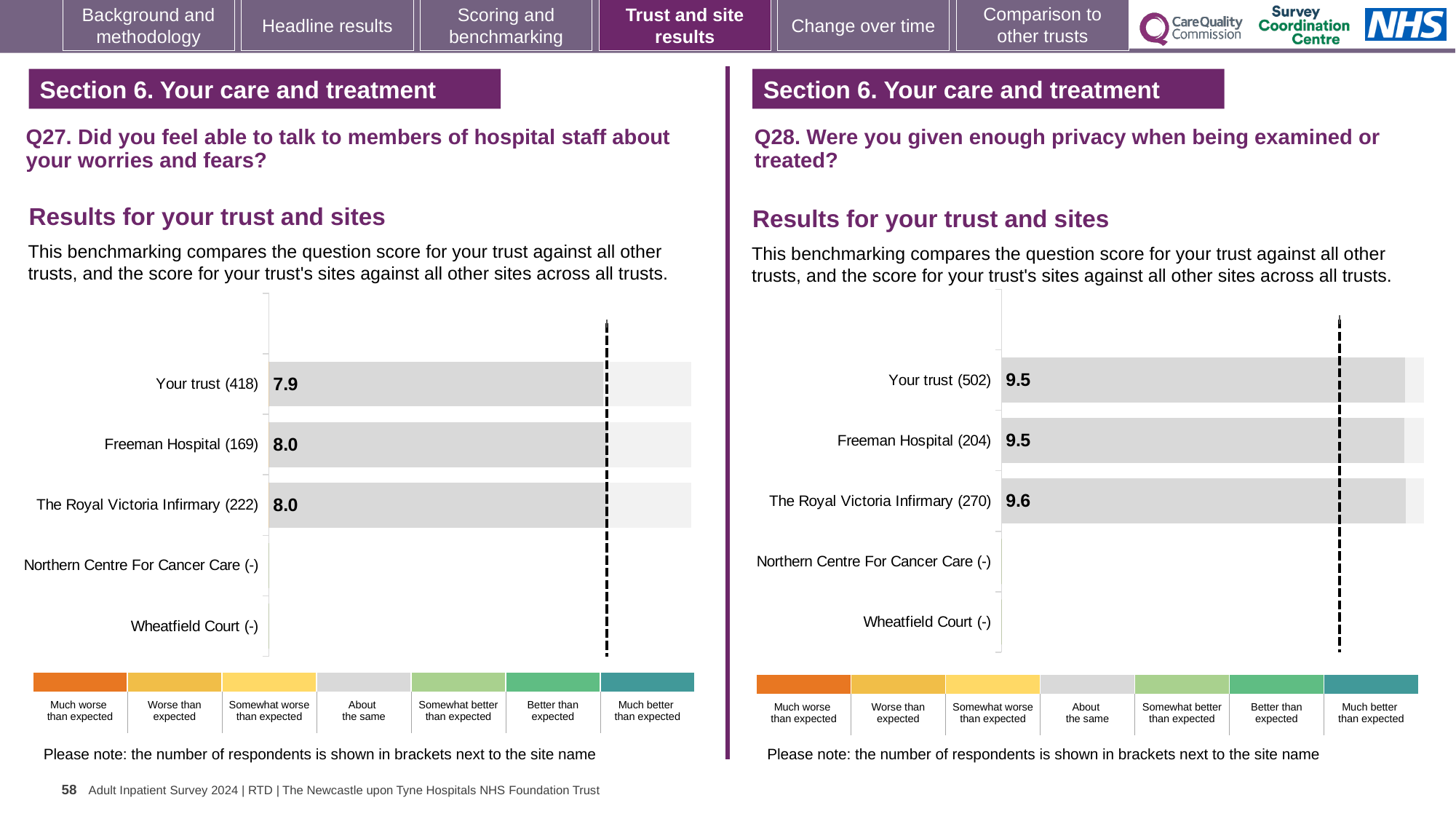
On the Q27 chart (left), which site or trust has the lowest score? Your trust On the Q28 chart (right), what is the score for Your trust? 9.5 How many sites or trusts are listed on the Q27 chart (left)? 5 On the Q28 chart (right), what is the score for The Royal Victoria Infirmary? 9.6 What kind of chart is the Q28 chart (right)? bar chart On the Q27 chart (left), how many respondents are shown in brackets for The Royal Victoria Infirmary? 222 On the Q28 chart (right), is the score for The Royal Victoria Infirmary larger or smaller than the score for Freeman Hospital? larger On the Q27 chart (left), what is the difference between the score for Freeman Hospital and the score for Your trust? 0.1 On the Q27 chart (left), what is the score for Your trust? 7.9 On the Q27 chart (left), what is the score for Freeman Hospital? 8.0 On the Q28 chart (right), which site or trust has the highest score? The Royal Victoria Infirmary On the Q28 chart (right), how many respondents are shown in brackets for Your trust? 502